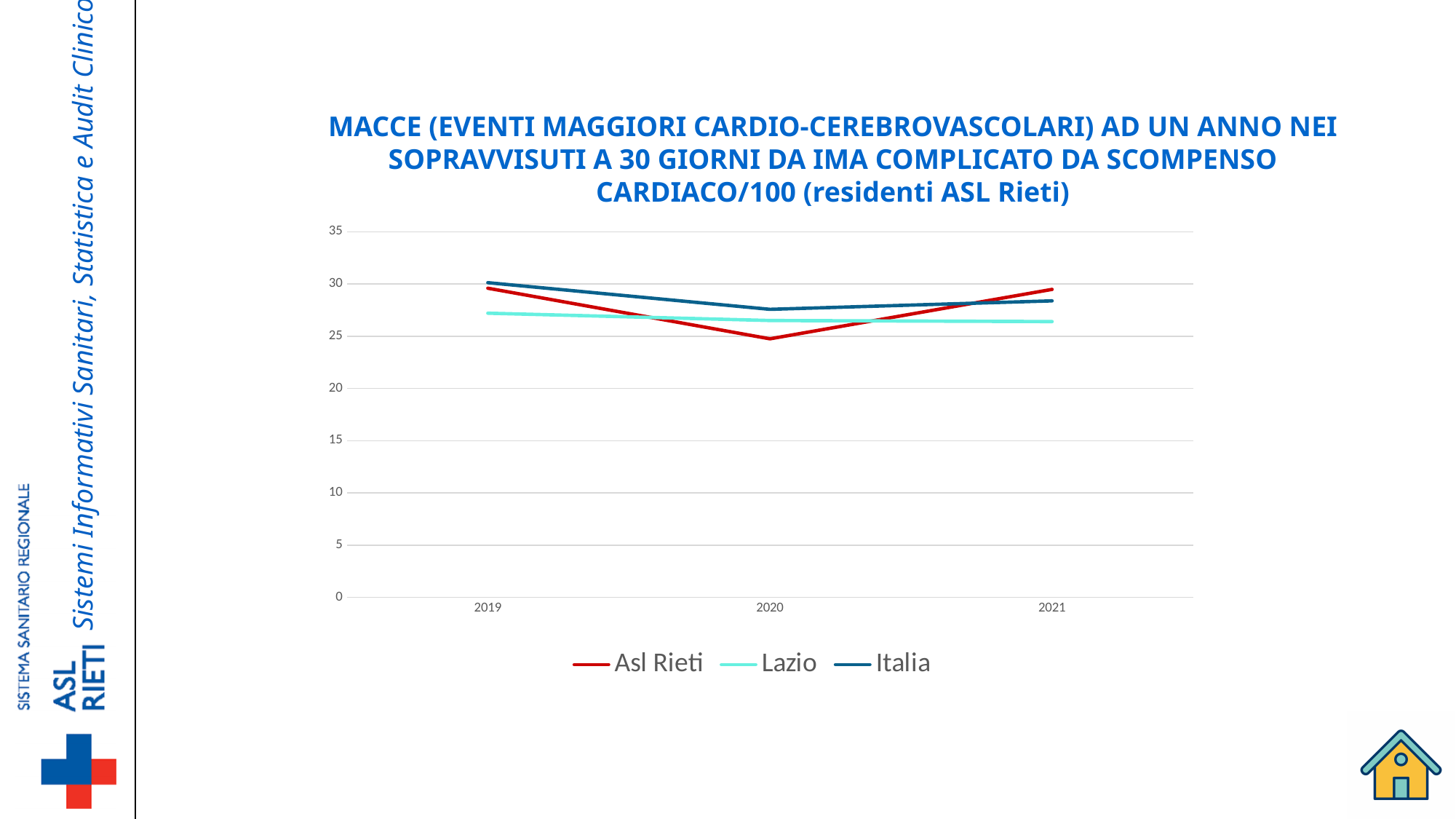
In which year is the Asl Rieti value lowest? 2020 How many years are shown on the x axis? 3 Is the value for Asl Rieti in 2020 greater or less than 30? less What kind of chart is shown on the slide? line chart Is the value for Lazio in 2019 greater or less than 25? greater Does the Lazio line rise or fall from 2019 to 2021? fall How many series does the legend list? 3 In which year is the Italia value highest? 2019 In 2020, which is larger, the value for Italia or the value for Asl Rieti? Italia Which series is drawn in red? Asl Rieti In 2019, which is larger, the value for Italia or the value for Lazio? Italia In 2021, which is larger, the value for Asl Rieti or the value for Lazio? Asl Rieti